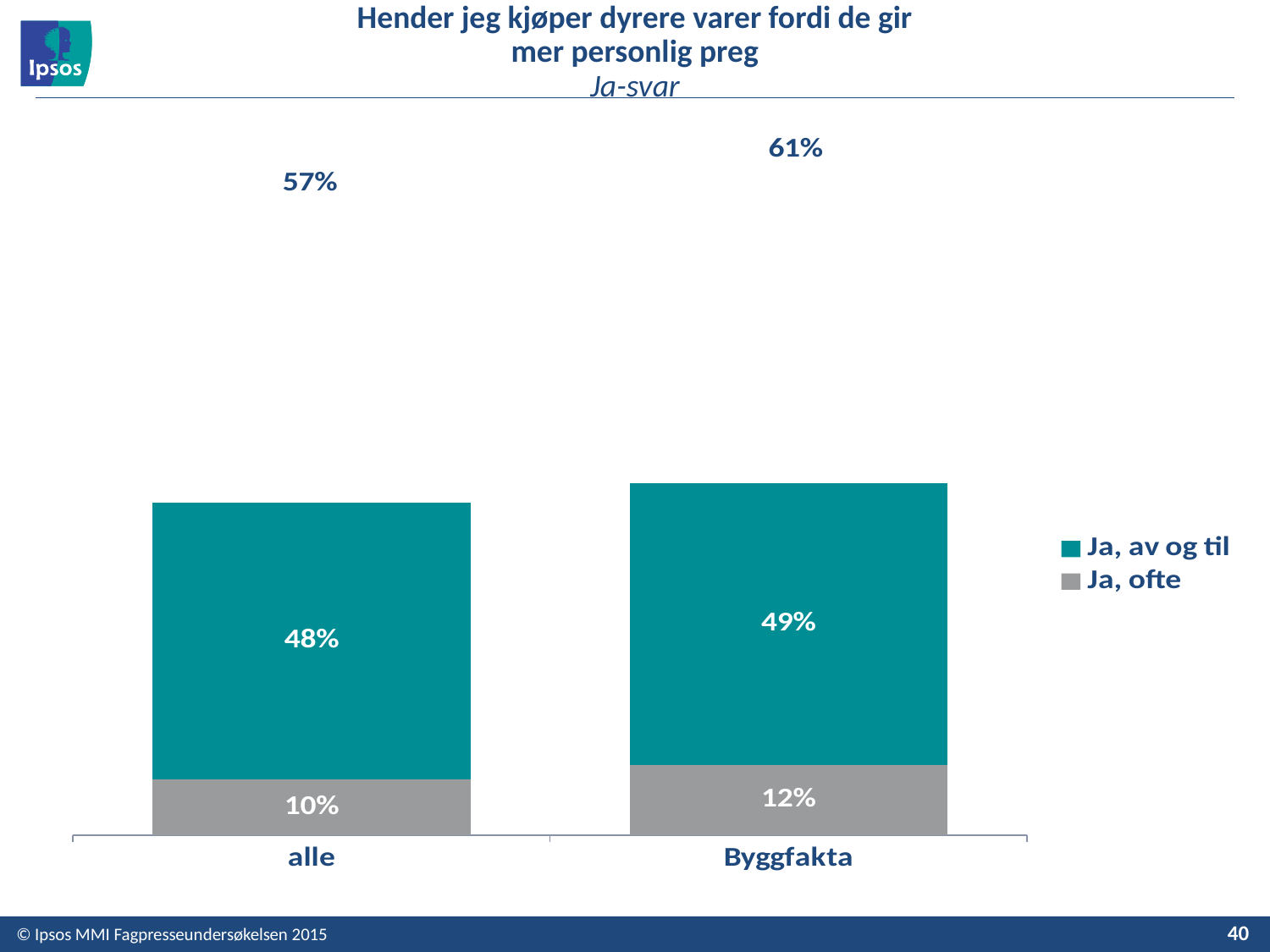
What is the total shown above the stacked bar for Byggfakta? 61% What is the total shown above the stacked bar for alle? 57% What is the value for 'Ja, av og til' for Byggfakta? 49% What is the value for 'Ja, ofte' for Byggfakta? 12% What is the difference between the totals for Byggfakta and alle? 4% What kind of chart is shown on the slide? Stacked bar chart How many series does the legend list? 2 What is the value for 'Ja, ofte' for alle? 10% What is the value for 'Ja, av og til' for alle? 48% Which category has the higher total, alle or Byggfakta? Byggfakta How many categories are shown on the x axis? 2 What is the difference between the 'Ja, ofte' values for Byggfakta and alle? 2%